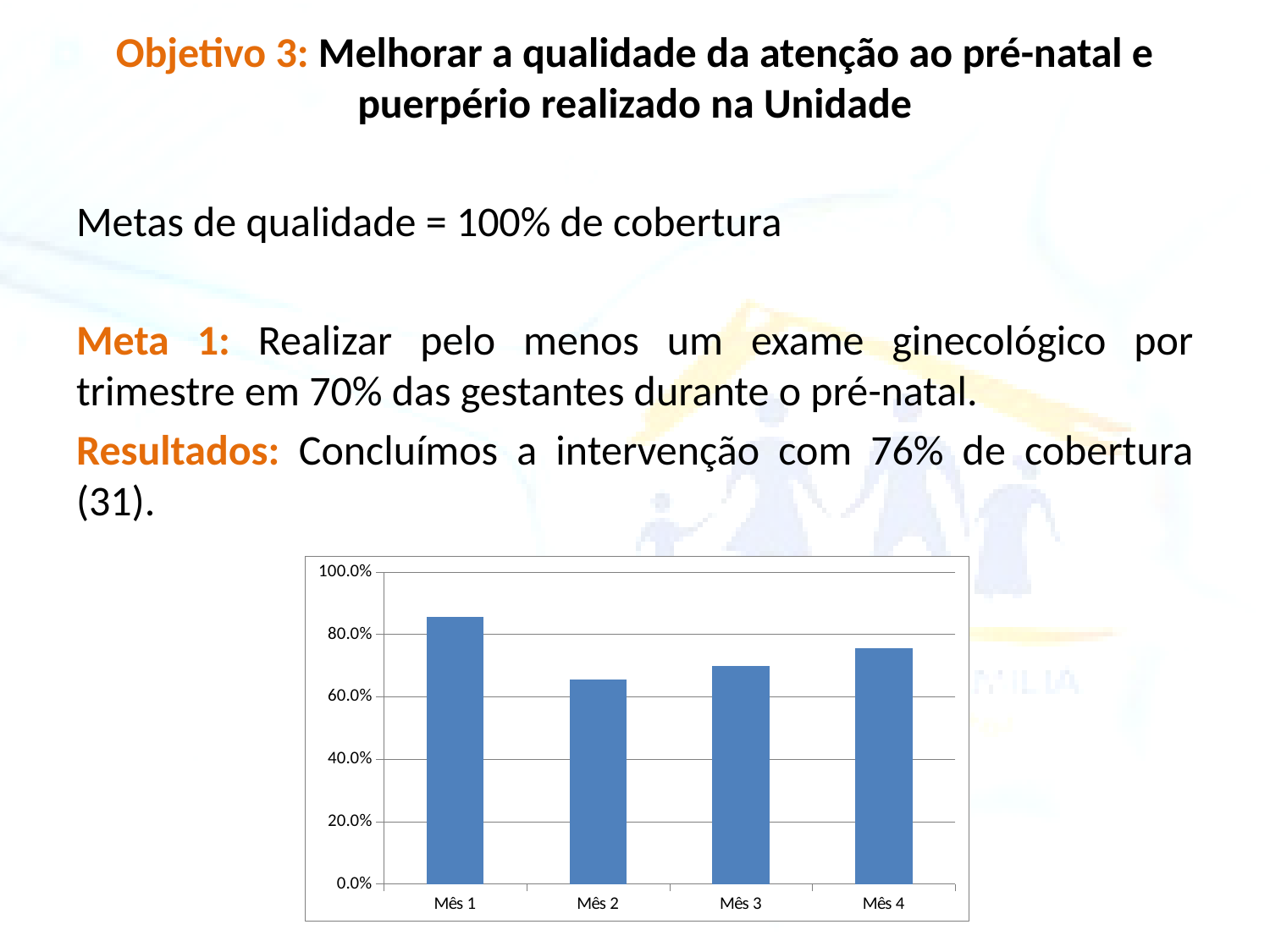
Do the values rise or fall from Mês 2 to Mês 4? rise How many categories (months) are plotted on the chart? 4 Is the value for Mês 4 greater or less than 80.0%? less Is the value for Mês 1 greater or less than 80.0%? greater Which month has the highest bar on the chart? Mês 1 Is the value for Mês 2 greater or less than 60.0%? greater Which is larger, the value for Mês 2 or the value for Mês 4? Mês 4 Which month has the lowest bar on the chart? Mês 2 Which is larger, the value for Mês 1 or the value for Mês 4? Mês 1 What is the highest value labelled on the vertical axis of the chart? 100.0% What kind of chart is shown on the slide? bar chart